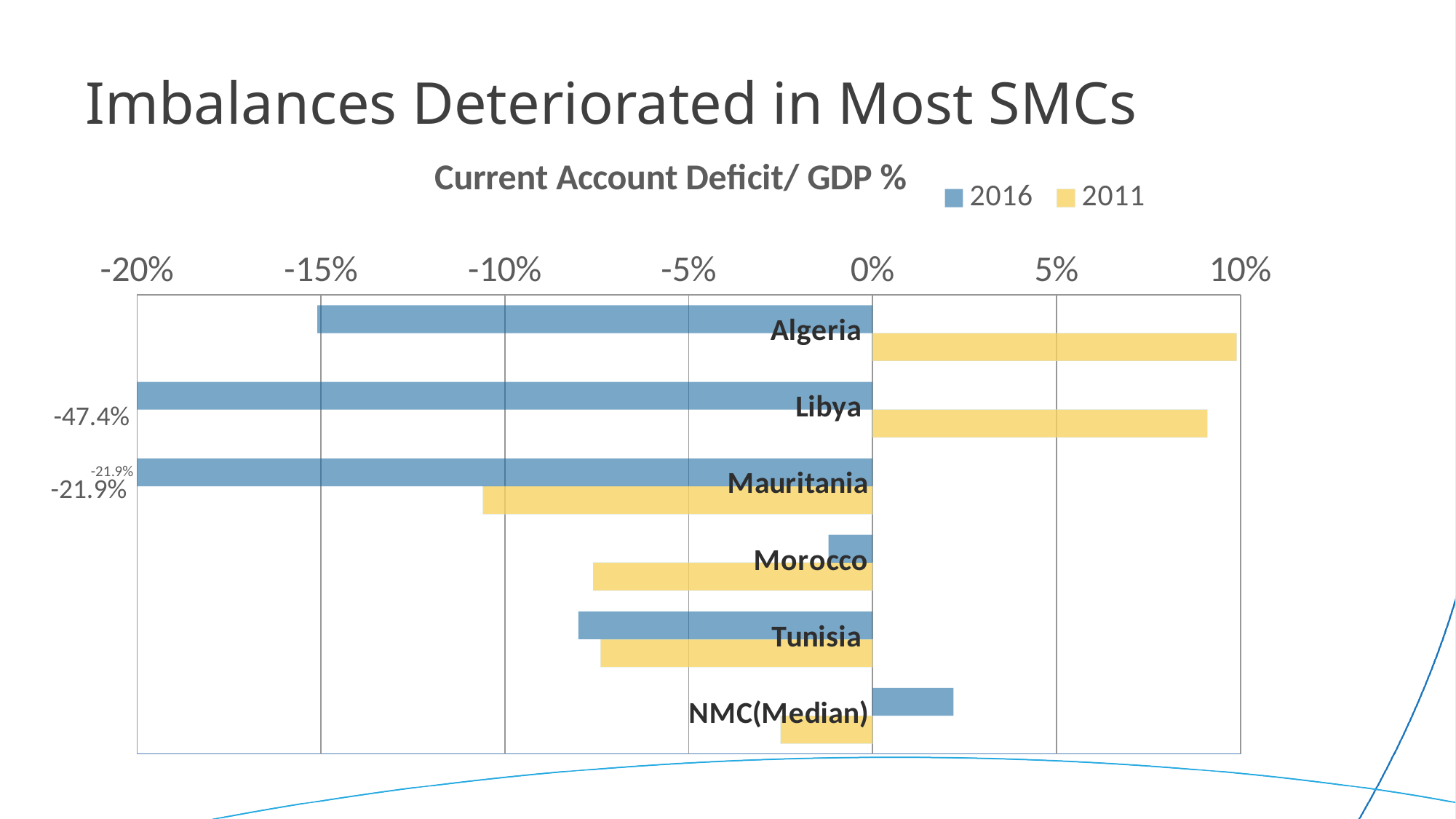
Which is larger, the 2016 value for Libya or the 2016 value for Mauritania? Mauritania Which category has the highest 2011 value? Algeria Which category has the lowest 2011 value? Mauritania Is the 2016 value for Morocco greater or less than -5%? greater What is the 2016 value for Libya? -47.4% Is the 2016 value for NMC(Median) greater or less than 0%? greater What is the 2016 value for Mauritania? -21.9% How many categories are shown on the chart? 6 Is the 2011 value for Libya greater or less than 5%? greater What is the difference between the 2016 values for Mauritania and Libya? 25.5 percentage points Which category has the lowest 2016 value? Libya How many series does the legend list? 2